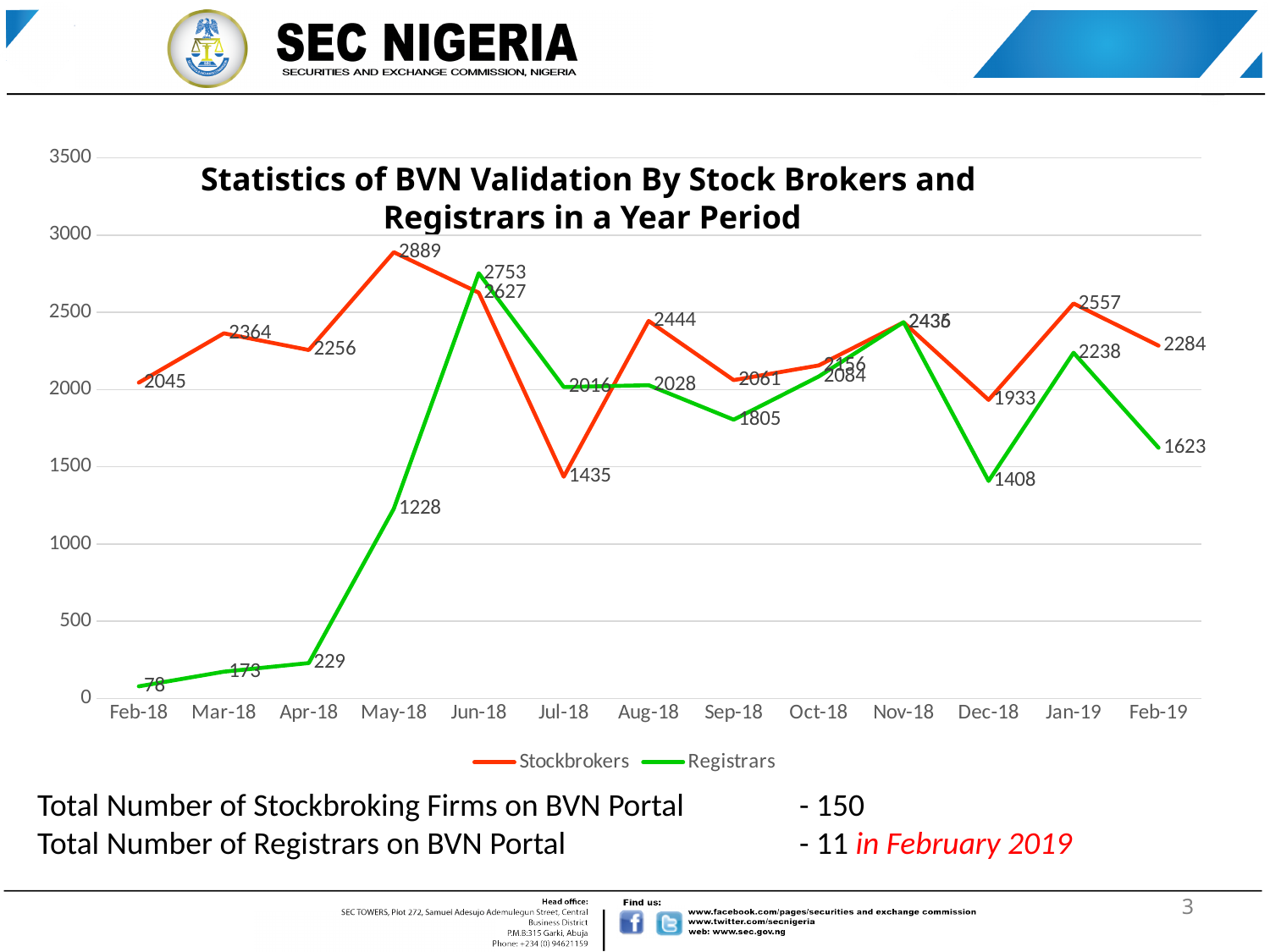
Which series has the higher value in Jun-18, Stockbrokers or Registrars? Registrars What colour is the Registrars line? green In which month is the Stockbrokers value highest? May-18 How many series does the legend list? 2 Do the Registrars values rise or fall from Feb-18 to May-18? rise What is the difference between the Stockbrokers values for Aug-18 and Jul-18? 1009 What kind of chart is shown on the slide? line chart What is the Registrars value for Dec-18? 1408 In which month is the Registrars value lowest? Feb-18 What is the Stockbrokers value for May-18? 2889 How many months are plotted along the x axis? 13 What is the Registrars value for Feb-18? 78